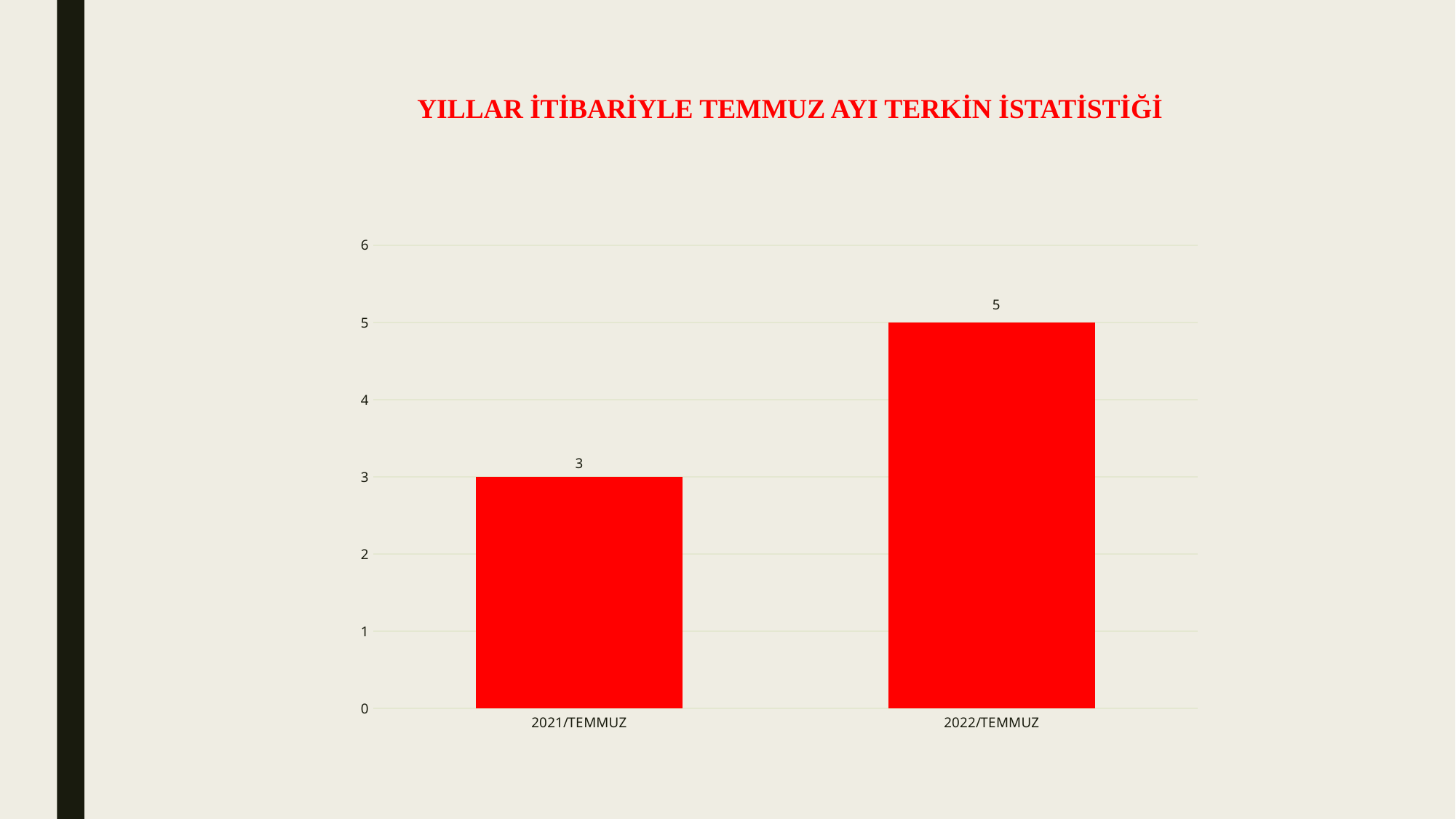
Do the values rise or fall from 2021/TEMMUZ to 2022/TEMMUZ? Rise What is the value for 2022/TEMMUZ? 5 Is the value for 2021/TEMMUZ greater or less than 4? less Is the value for 2022/TEMMUZ greater or less than 4? greater What kind of chart is shown on the slide? Bar chart What is the difference between the values for 2022/TEMMUZ and 2021/TEMMUZ? 2 What is the value for 2021/TEMMUZ? 3 Which category has the highest value? 2022/TEMMUZ What is the title of the chart? YILLAR İTİBARİYLE TEMMUZ AYI TERKİN İSTATİSTİĞİ Which is larger, the value for 2021/TEMMUZ or the value for 2022/TEMMUZ? 2022/TEMMUZ Which category has the lowest value? 2021/TEMMUZ How many categories are shown on the x axis? 2